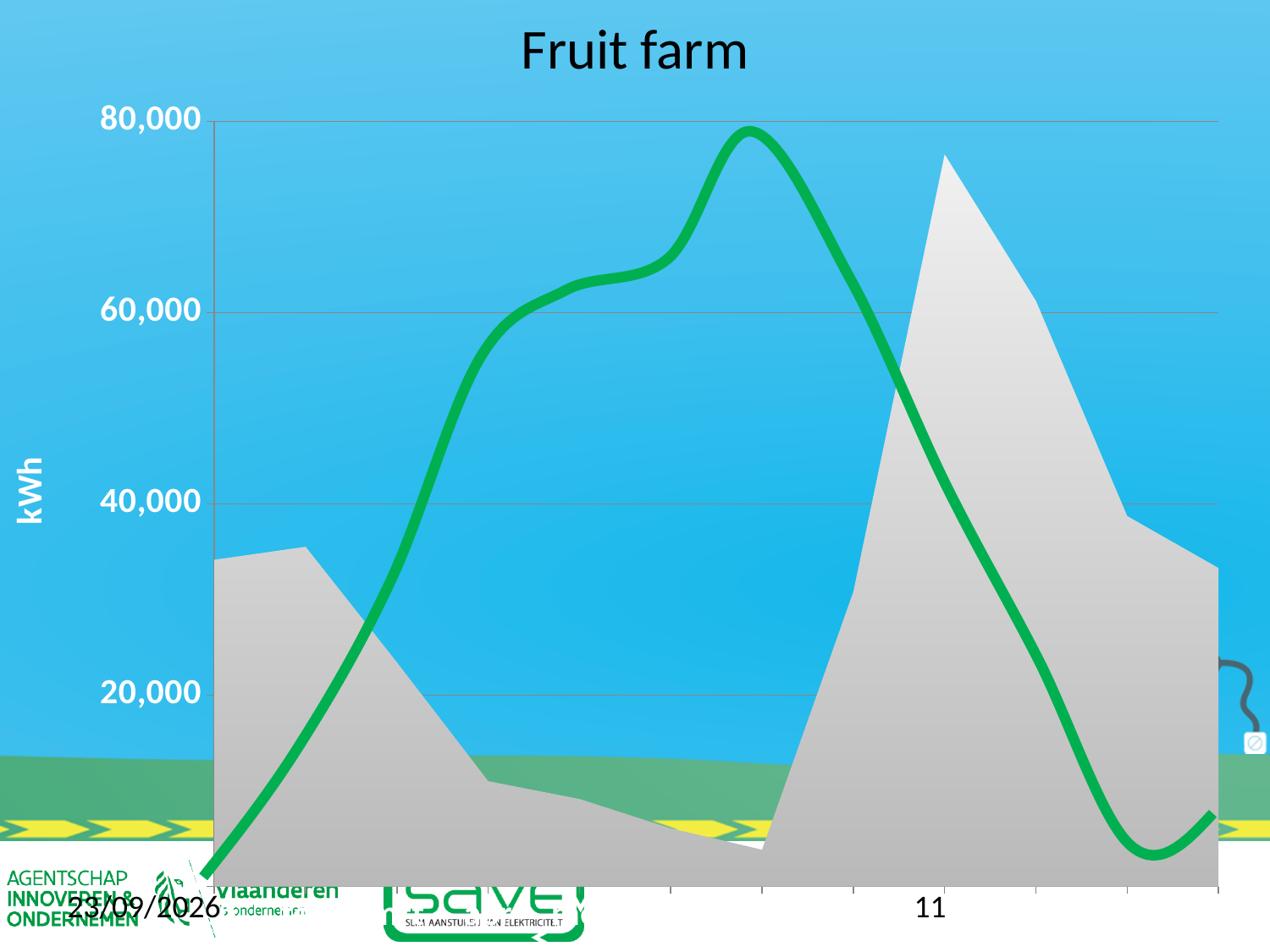
What is the highest value shown on the vertical axis? 80,000 What is the label on the vertical axis of the chart? kWh Is the first (leftmost) value of the grey area greater or less than 40,000? less What is the title of the chart? Fruit farm Is the highest point of the grey area greater or less than 60,000? greater Which series reaches the higher peak, the green line or the grey area? The green line How many data series are plotted on the chart? 1 What kind of chart is shown on the slide? A line chart combined with an area chart Is the lowest point of the green line greater or less than 20,000? less